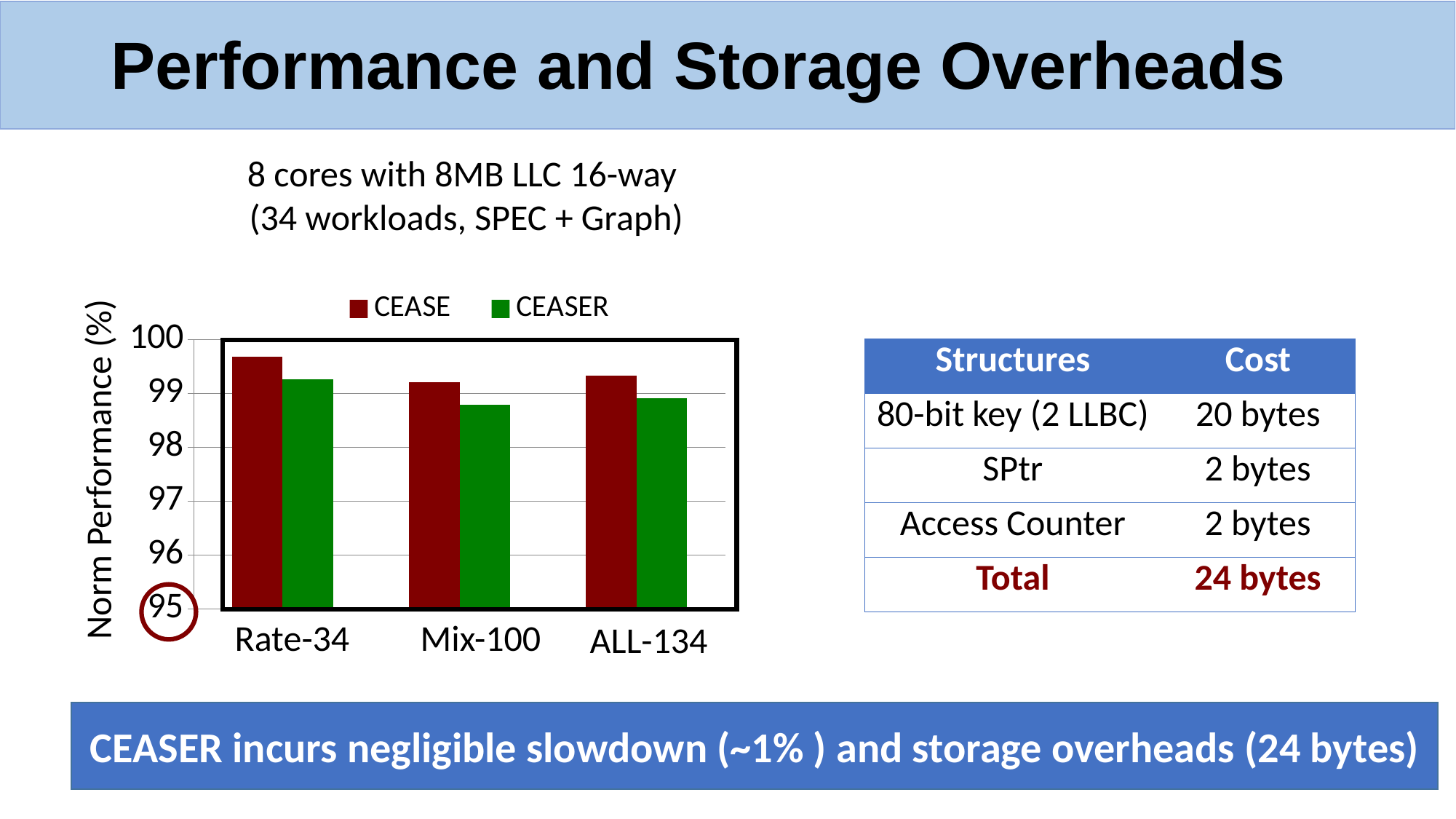
Which series has the higher value for Mix-100, CEASE or CEASER? CEASE What kind of chart is shown on the slide? bar chart What is the label of the y axis of the chart? Norm Performance (%) Is the CEASER value for Mix-100 greater or less than 99? less How many series does the chart's legend list? 2 Is the CEASER value for Rate-34 greater or less than 99? greater Which series has the higher value for ALL-134, CEASE or CEASER? CEASE Among the CEASE bars, which category has the highest value? Rate-34 Which series has the higher value for Rate-34, CEASE or CEASER? CEASE Which colour represents the CEASER series in the chart? green Is the CEASE value for Rate-34 greater or less than 99? greater How many categories are shown on the x axis of the chart? 3